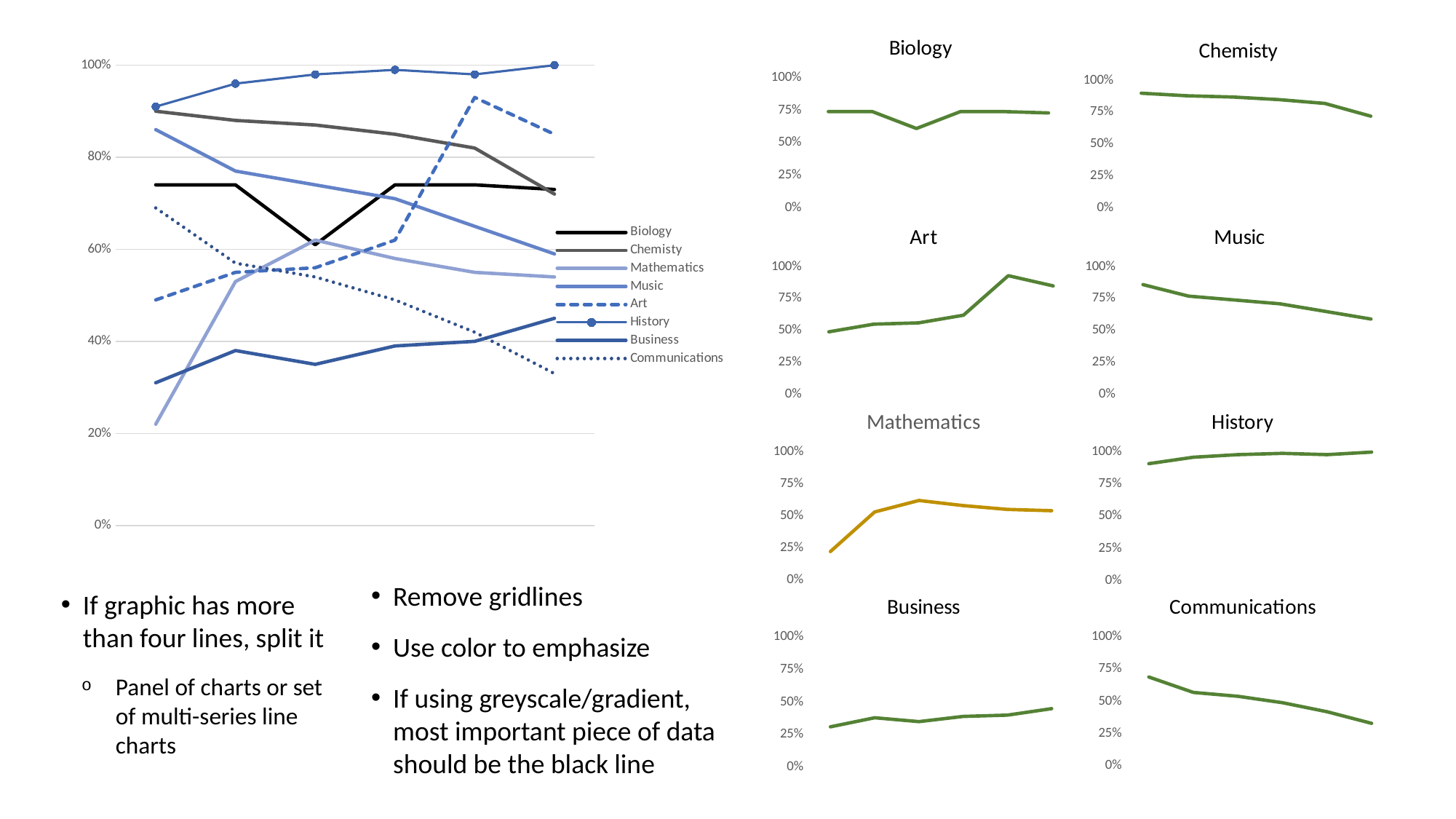
In the large chart on the left, at the rightmost point, which is larger: Business or Communications? Business How many series does the legend of the large chart on the left list? 8 In the large chart on the left, which series has the highest value at the rightmost point? History Which of the small panel charts on the right is drawn in a different colour (orange) from the others? Mathematics In the large chart on the left, do the values of the Communications series rise or fall along the x axis? fall How many small panel charts are shown on the right side of the slide? 8 In the large chart on the left, which series has the lowest value at the leftmost point? Mathematics In the large chart on the left, how many data points does the History series have? 6 In the small Music chart on the right, do the values rise or fall along the x axis? fall In the large chart on the left, is the first value of the Mathematics series greater or less than 40%? less What kind of chart is the large chart on the left of the slide? line chart In the large chart on the left, is the last value of the Communications series greater or less than 40%? less